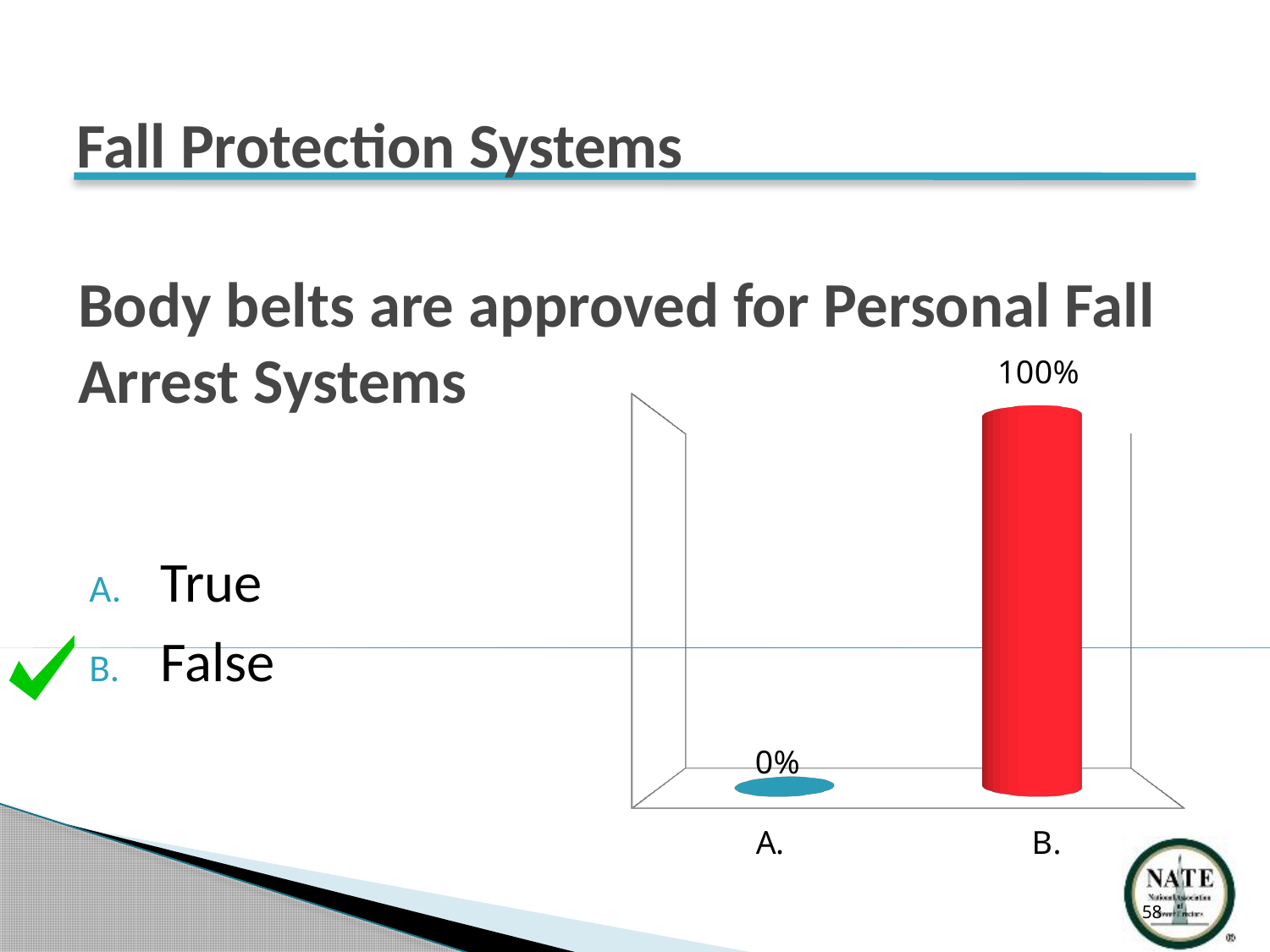
Which category has the lowest value in the chart? A. Do the values rise or fall from A. to B. along the x axis? Rise Which category has the highest value in the chart? B. What is the value for category A. in the chart? 0% How many categories are shown in the chart? 2 Which category has the larger value, A. or B.? B. What kind of chart is shown on the slide? Bar chart What is the difference between the values for B. and A.? 100% What colour is the bar for category A.? Blue What is the value for category B. in the chart? 100% What colour is the bar for category B.? Red